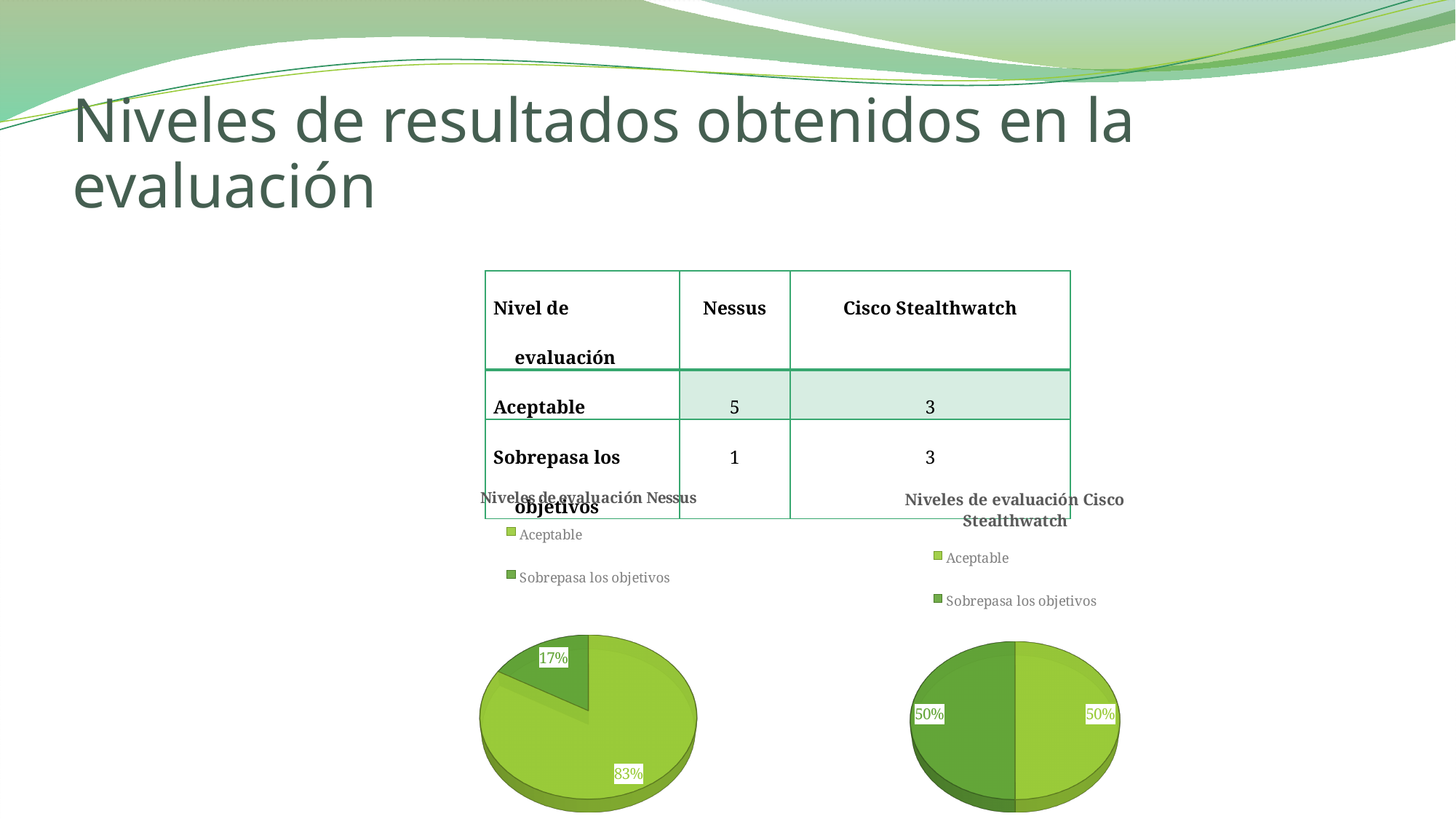
In the 'Niveles de evaluación Cisco Stealthwatch' chart, what share of the pie is labelled for Aceptable? 50% In the 'Niveles de evaluación Nessus' chart, what is the difference in percentage points between the Aceptable slice and the Sobrepasa los objetivos slice? 66 How many entries does the legend of the 'Niveles de evaluación Cisco Stealthwatch' chart list? 2 How many slices does the 'Niveles de evaluación Nessus' pie chart have? 2 In the 'Niveles de evaluación Cisco Stealthwatch' chart, what share of the pie is labelled for Sobrepasa los objetivos? 50% In the 'Niveles de evaluación Nessus' chart, which category has the smallest slice? Sobrepasa los objetivos In the 'Niveles de evaluación Nessus' chart, what share of the pie is labelled for Aceptable? 83% In the 'Niveles de evaluación Nessus' chart, which is larger, the Aceptable slice or the Sobrepasa los objetivos slice? Aceptable What is the title of the pie chart on the left of the slide? Niveles de evaluación Nessus What kind of chart is 'Niveles de evaluación Cisco Stealthwatch'? Pie chart In the 'Niveles de evaluación Nessus' chart, which category has the largest slice? Aceptable